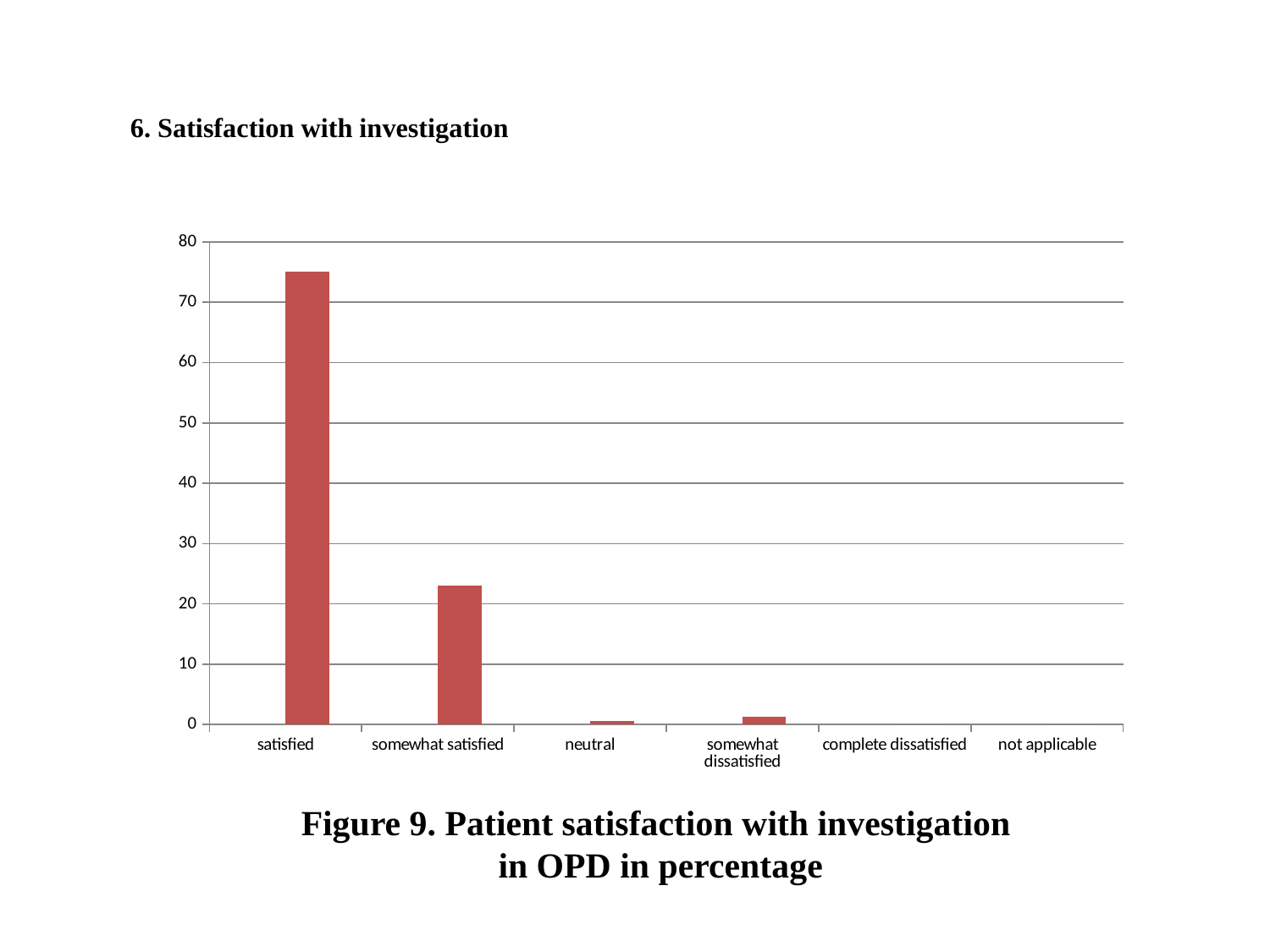
Which category has the highest bar in the chart? satisfied Is the value for satisfied greater or less than 70? greater What is the highest value shown on the y axis of the chart? 80 Is the value for satisfied greater or less than 80? less Is the value for somewhat satisfied greater or less than 20? greater What is the figure caption shown below the chart? Figure 9. Patient satisfaction with investigation in OPD in percentage Which is larger, the value for satisfied or the value for somewhat satisfied? satisfied How many categories are shown on the x axis of the chart? 6 Which is larger, the value for somewhat satisfied or the value for neutral? somewhat satisfied What kind of chart is shown on the slide? bar chart